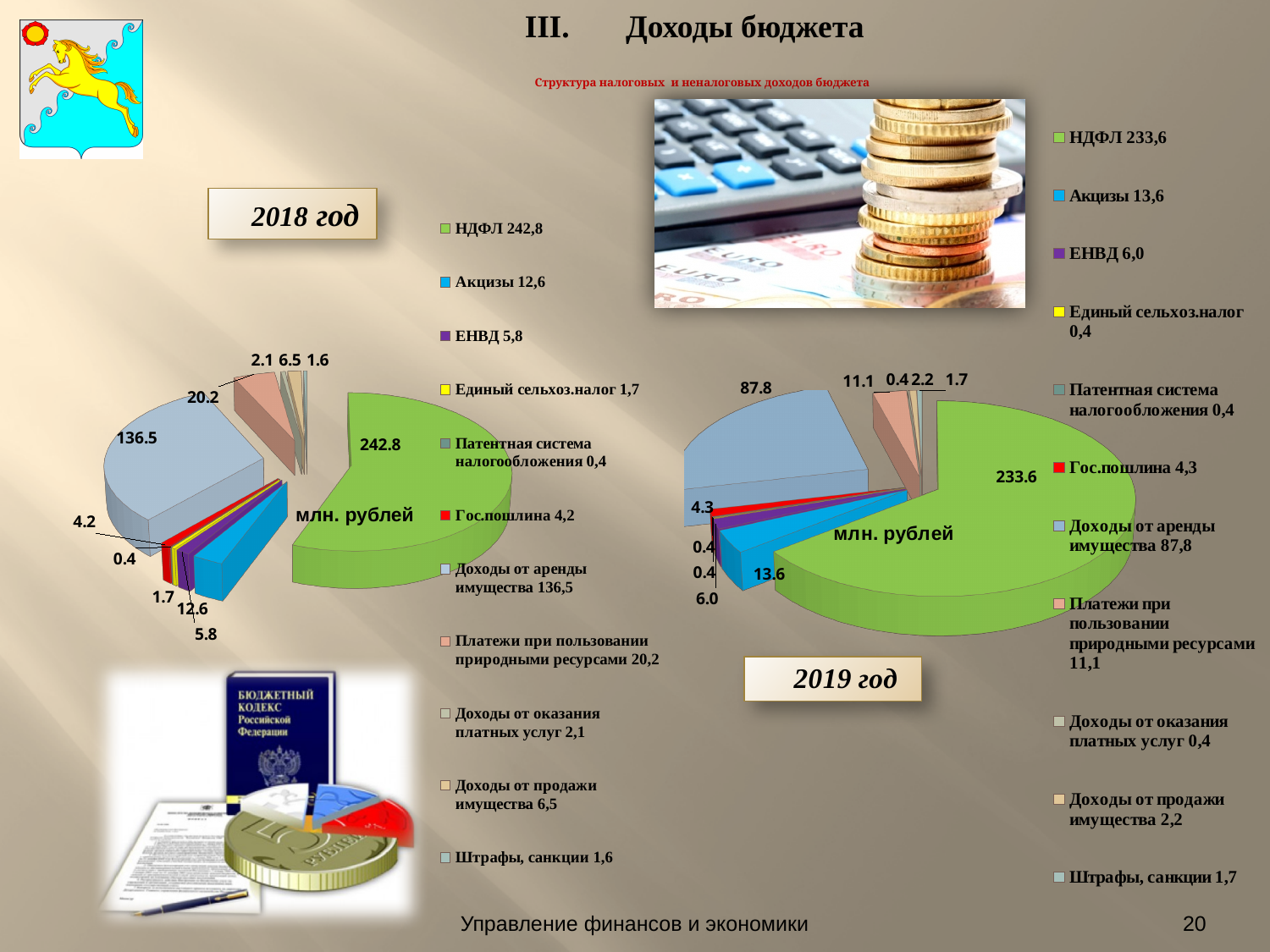
On the 2019 chart, what is the value for Доходы от аренды имущества? 87.8 On the 2018 chart, which category has the largest value? НДФЛ How many categories does the 2019 chart show? 11 What kind of chart is the 2018 chart? Pie chart What unit is shown in the centre of both charts? млн. рублей On the 2018 chart, which is larger: Платежи при пользовании природными ресурсами or Акцизы? Платежи при пользовании природными ресурсами What is the difference between the НДФЛ value on the 2018 chart and the НДФЛ value on the 2019 chart? 9.2 On the 2018 chart, what is the value for НДФЛ? 242.8 On the 2019 chart, what is the value for Акцизы? 13.6 On the 2019 chart, what is the value for Гос.пошлина? 4.3 On the 2019 chart, what is the difference between Платежи при пользовании природными ресурсами and Акцизы? 2.5 On the 2018 chart, which category has the smallest value? Патентная система налогообложения